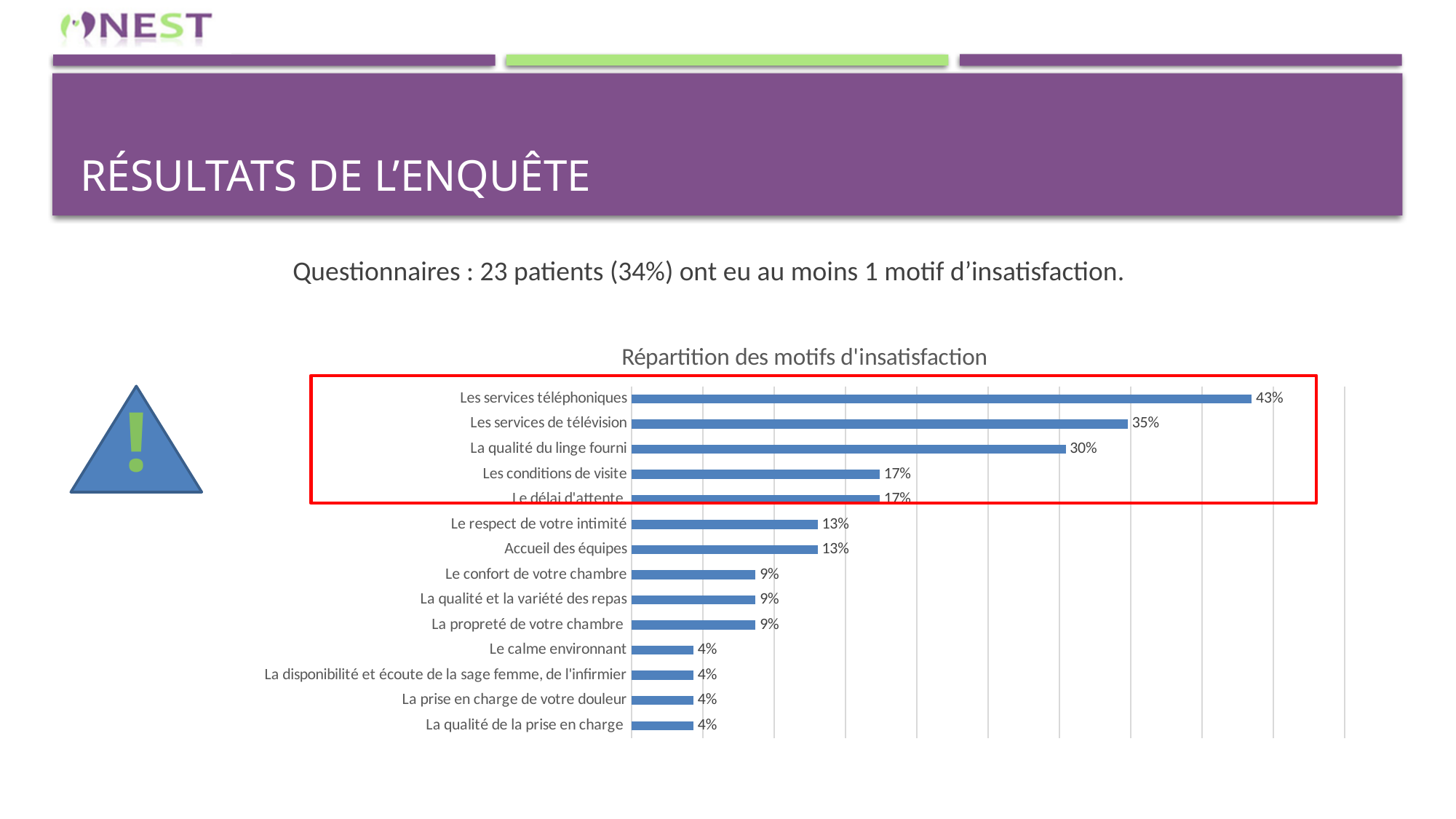
What is the title of the chart? Répartition des motifs d'insatisfaction What is the difference between "Les services téléphoniques" and "Les services de télévision"? 8% How many categories have a value of 4%? 4 Which is larger, "Les services de télévision" or "Le confort de votre chambre"? Les services de télévision What is the value for "Le respect de votre intimité"? 13% What is the difference between "La qualité du linge fourni" and "Les conditions de visite"? 13% Which category has the highest value? Les services téléphoniques What is the value for "Le calme environnant"? 4% What kind of chart is shown? Bar chart How many categories are shown in the chart? 14 What is the value for "La qualité du linge fourni"? 30% What is the value for "Les services téléphoniques"? 43%